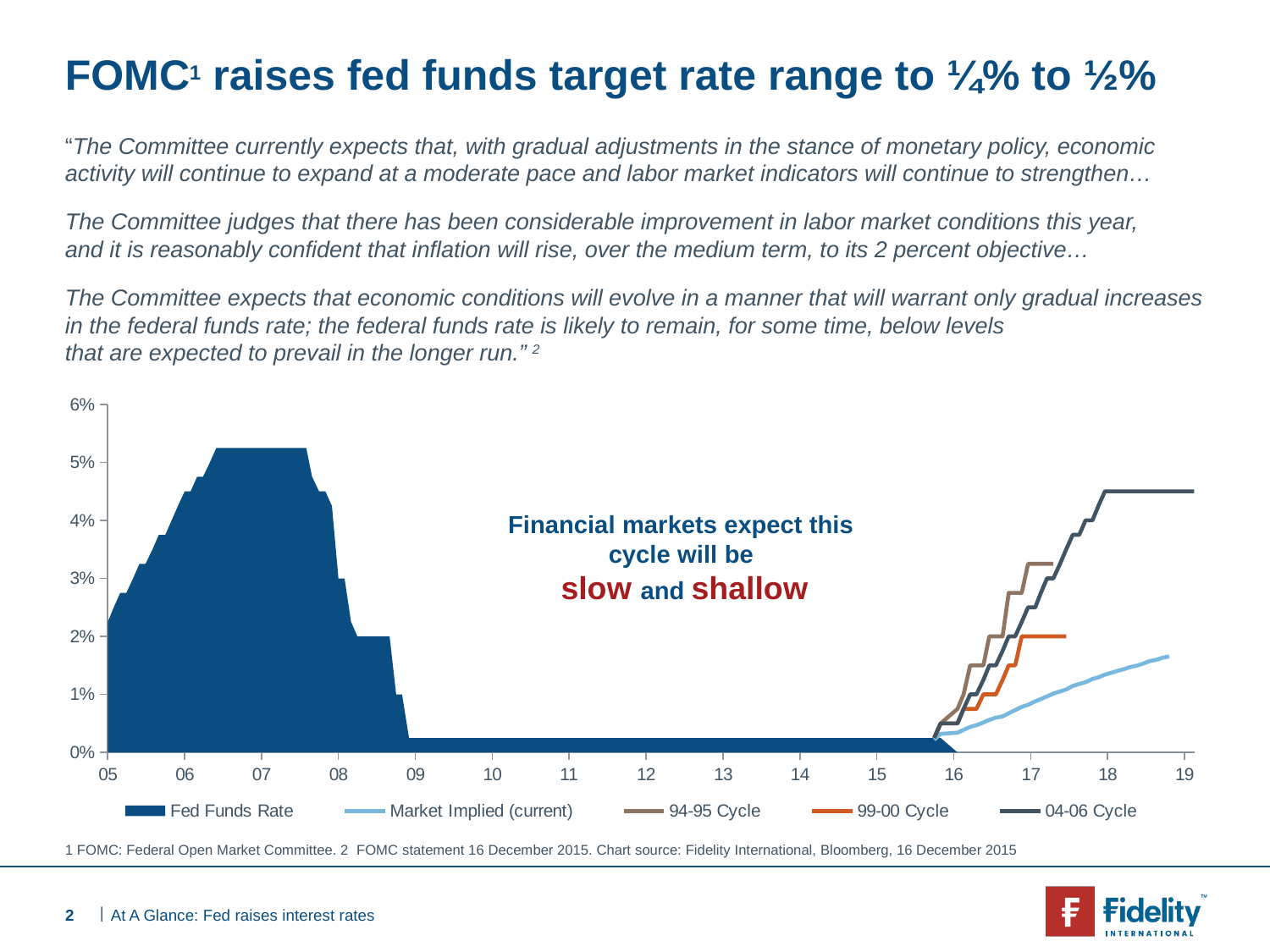
Does the Market Implied (current) line rise or fall from 16 to 19? rise What kind of chart is shown on the slide? area and line chart Which of the three historical cycle lines (94-95, 99-00, 04-06) reaches the lowest peak level? 99-00 Cycle Is the value of the 94-95 Cycle line at its end greater or less than 3%? greater Is the Fed Funds Rate in 2007 greater or less than 5%? greater Which of the three historical cycle lines (94-95, 99-00, 04-06) reaches the highest level? 04-06 Cycle Is the value of the Market Implied (current) line at 19 greater or less than 2%? less How many series does the chart legend list? 5 What message is written in the middle of the chart about what financial markets expect this cycle will be? slow and shallow At 17 on the x axis, which is higher: the 94-95 Cycle line or the Market Implied (current) line? 94-95 Cycle